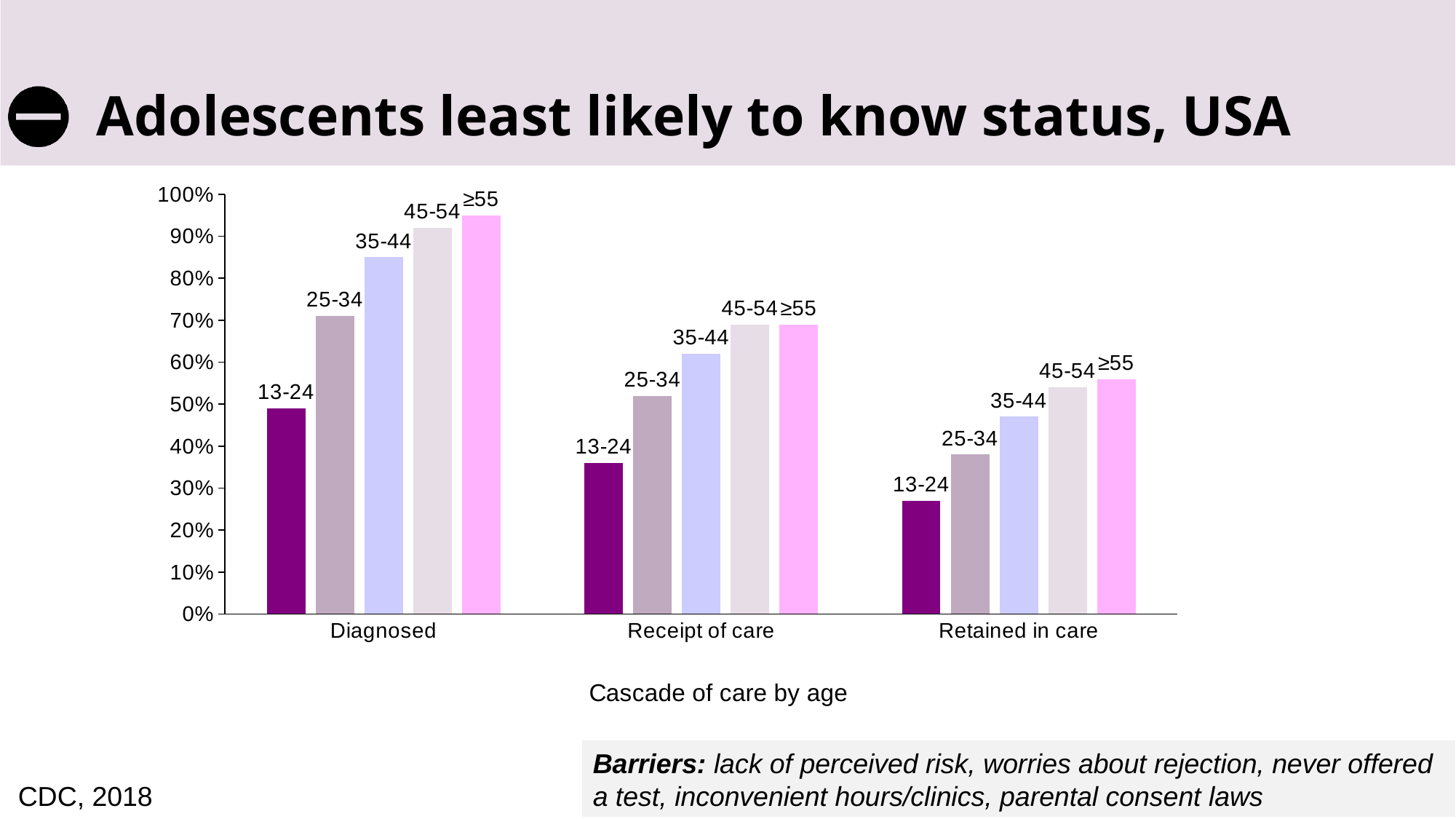
Within the Receipt of care category, do the bars rise or fall as the age group increases from 13-24 to ≥55? rise How many cascade-of-care categories are shown along the x axis? 3 How many age-group bars are shown for the Diagnosed category? 5 Which age group has the highest bar in the Diagnosed category? ≥55 Is the value for the ≥55 age group in the Retained in care category greater or less than 50%? greater What kind of chart is shown on the slide? bar chart Which is larger: the 13-24 bar in the Diagnosed category or the 13-24 bar in the Retained in care category? Diagnosed Which age group has the lowest bar in the Diagnosed category? 13-24 Which age group has the lowest bar in the Retained in care category? 13-24 Is the value for the ≥55 age group in the Diagnosed category greater or less than 90%? greater Is the value for the 13-24 age group in the Retained in care category greater or less than 30%? less